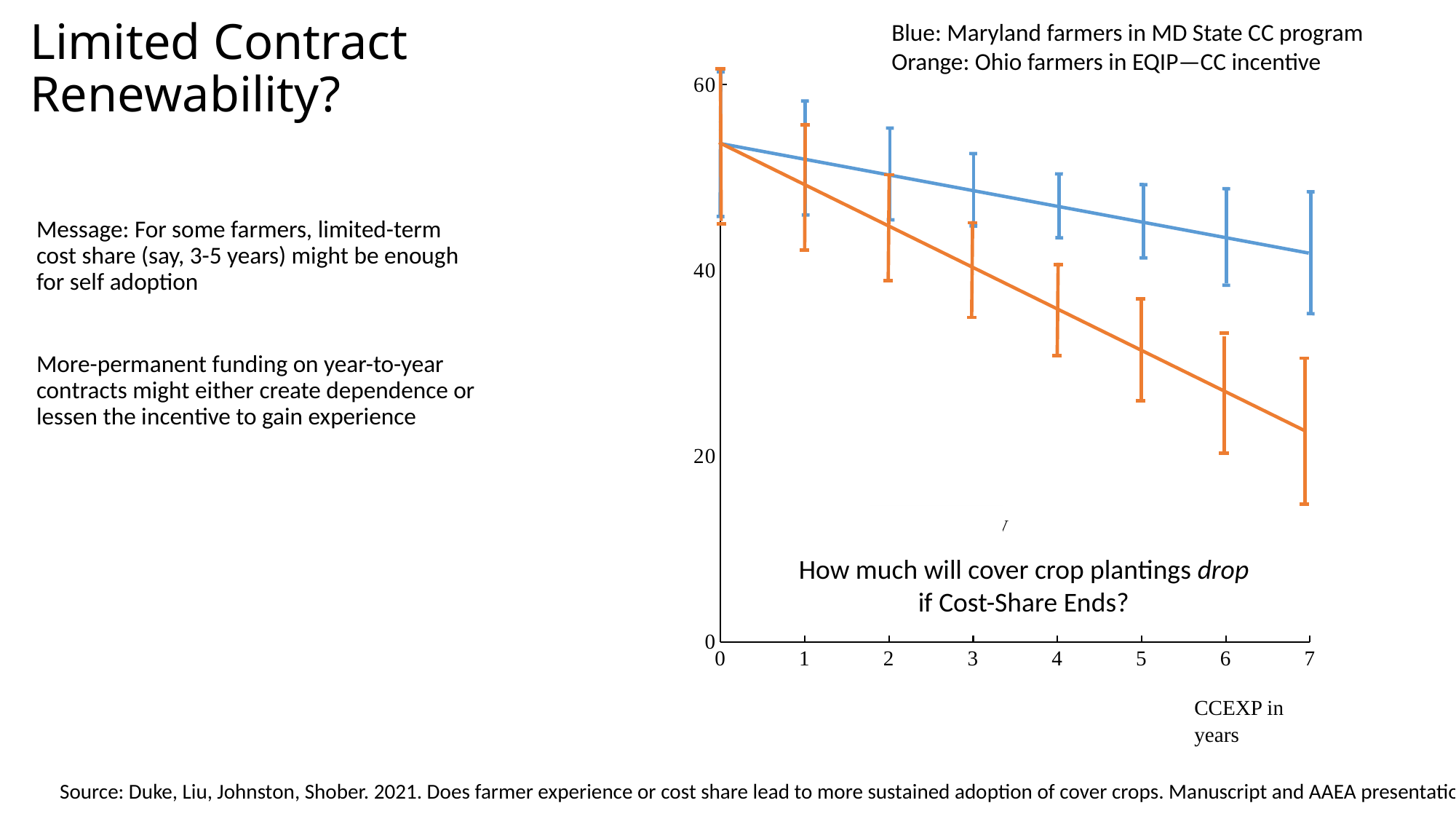
Which series does the orange line represent? Ohio farmers in EQIP—CC incentive Is the value of the orange line at 4 years greater or less than 40? less How many points along the x axis (CCEXP in years) are plotted for each series? 8 How many series are plotted on the chart? 2 What kind of chart is shown on the slide? line chart Do the values of the blue line rise or fall as CCEXP in years increases? fall Is the value of the orange line at 6 years greater or less than 20? greater Do the values of the orange line rise or fall as CCEXP in years increases? fall At CCEXP of 7 years, which line has the larger value, blue or orange? blue Which series does the blue line represent? Maryland farmers in MD State CC program Is the value of the orange line at 7 years greater or less than 40? less